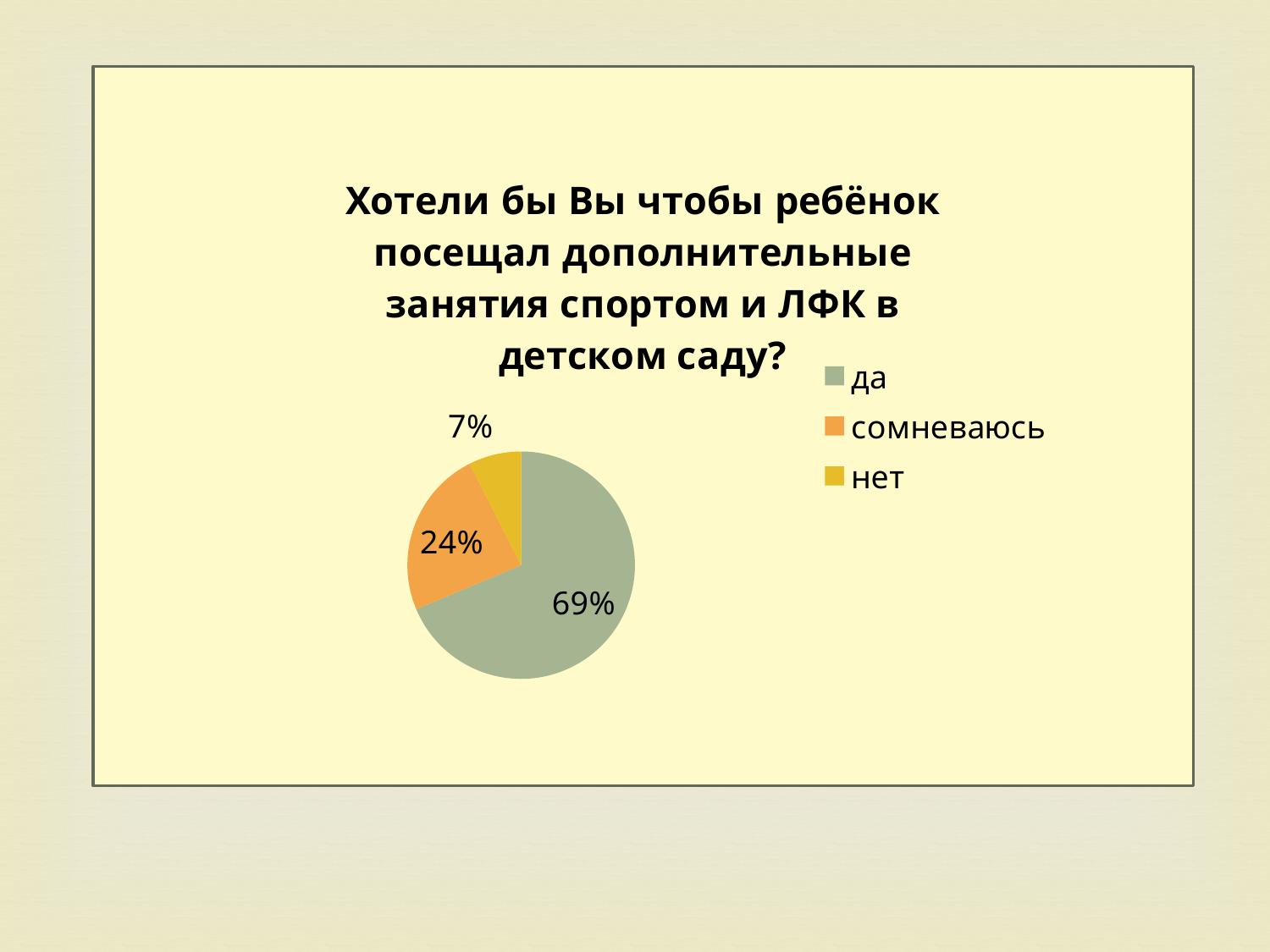
What share of the pie does "да" have? 69% What kind of chart is shown on the slide? pie chart How many categories does the pie chart have? 3 What is the title of the chart? Хотели бы Вы чтобы ребёнок посещал дополнительные занятия спортом и ЛФК в детском саду? Which category has the largest slice of the pie? да What share of the pie does "нет" have? 7% Which is larger, the share for "сомневаюсь" or the share for "нет"? сомневаюсь What is the difference between the shares for "сомневаюсь" and "нет"? 17% What is the difference between the shares for "да" and "сомневаюсь"? 45% Which colour represents "сомневаюсь" in the legend? orange What share of the pie does "сомневаюсь" have? 24% Which category has the smallest slice of the pie? нет